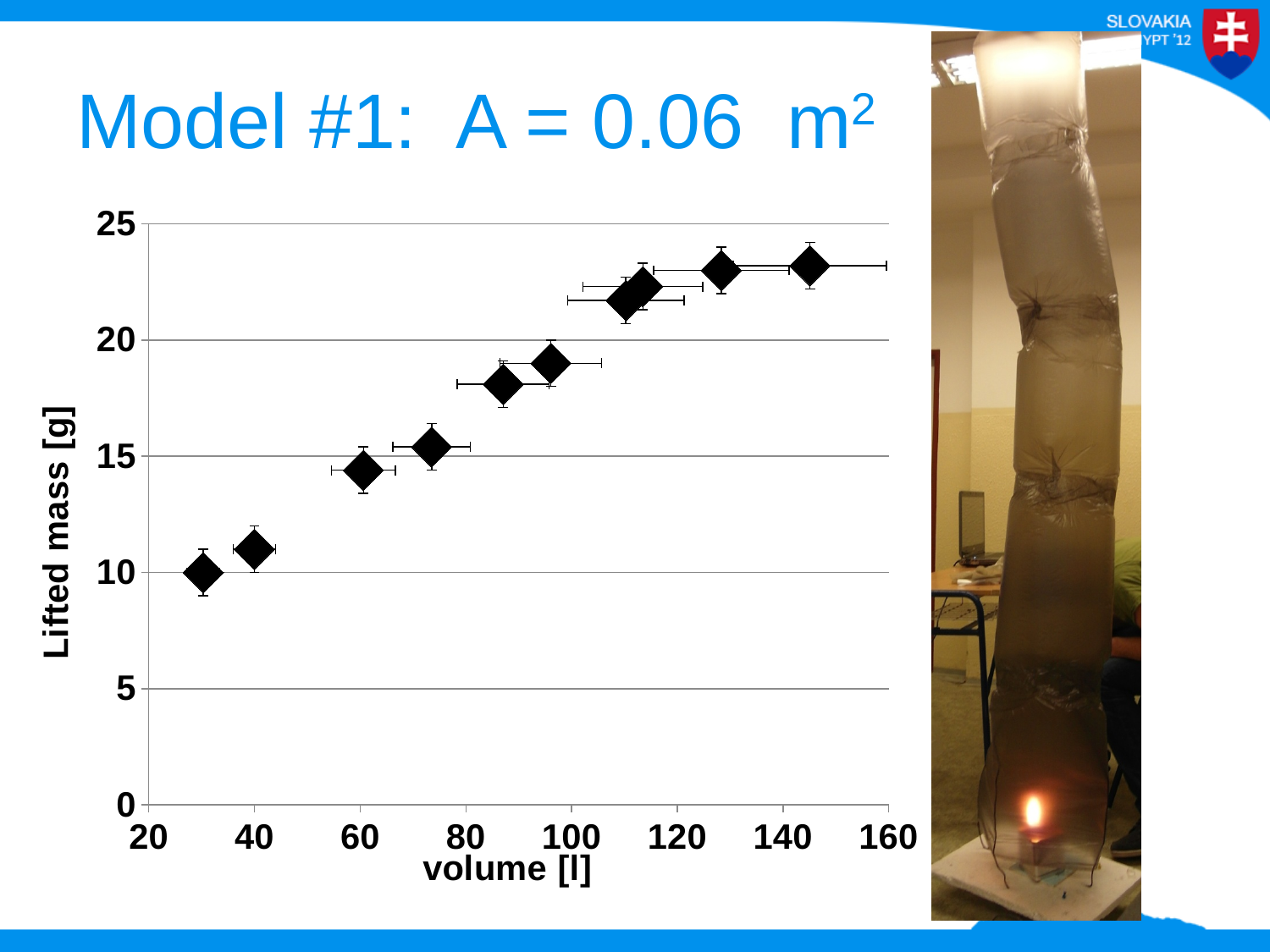
What is the highest value shown on the y axis of the chart? 25 Do the lifted mass values rise or fall as volume increases along the x axis? rise Is the lifted mass for the point at about 96 l volume greater or less than 20? less What is the label of the y axis of the chart? Lifted mass [g] Is the lifted mass for the rightmost point (about 145 l) greater or less than 20? greater Is the lifted mass for the point at about 60 l volume greater or less than 10? greater What kind of chart is shown on the slide? scatter chart Which point has the larger lifted mass: the one at about 73 l or the one at about 128 l? the one at about 128 l What is the title of the slide containing the chart? Model #1: A = 0.06 m² Which point has the larger lifted mass: the one at about 30 l or the one at about 60 l? the one at about 60 l